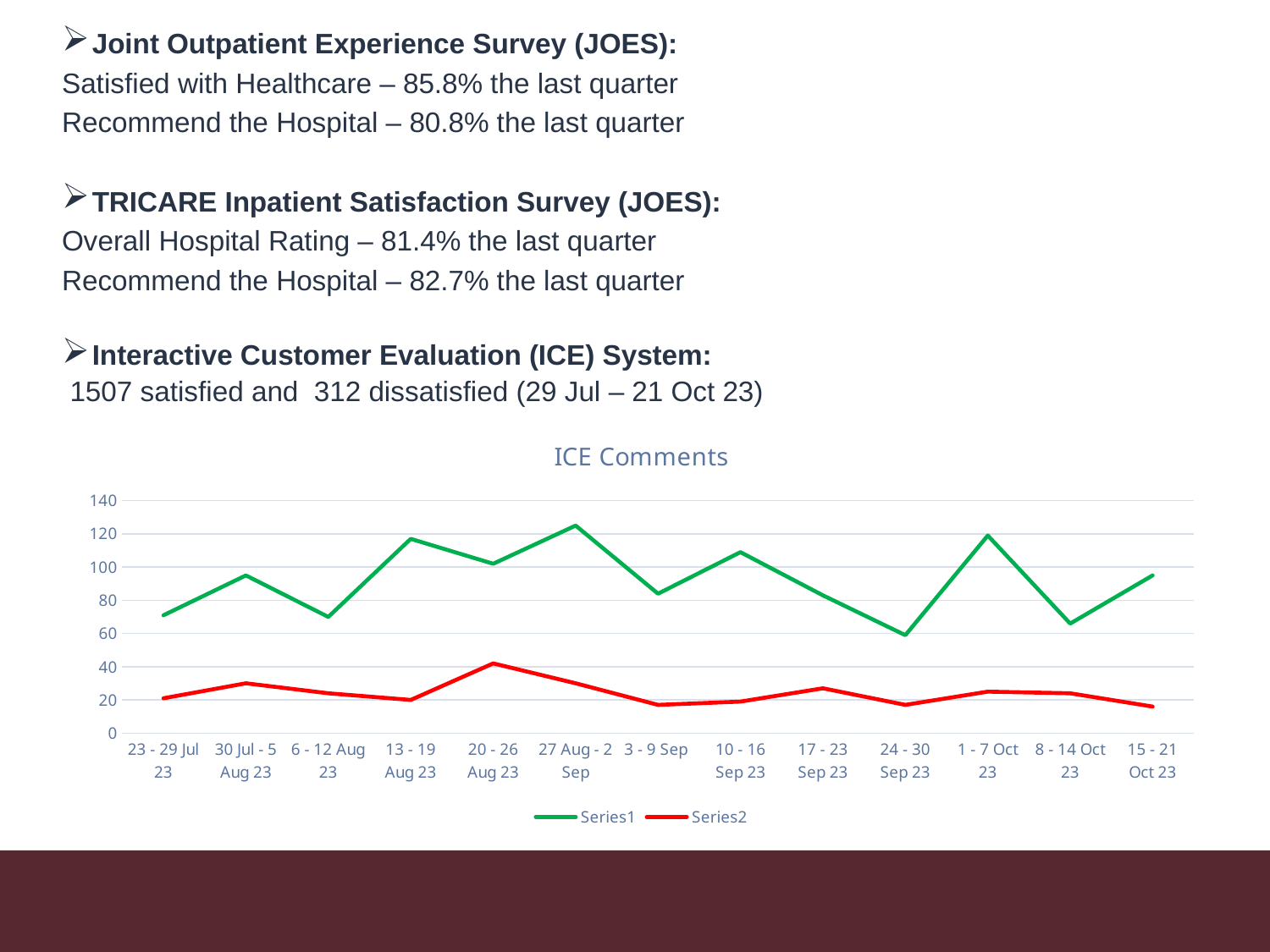
In the ICE Comments chart, which series has the larger value for 10 - 16 Sep 23, Series1 or Series2? Series1 What is the title of the chart on the slide? ICE Comments In the ICE Comments chart, is the Series1 value for 27 Aug - 2 Sep greater or less than 120? greater In the ICE Comments chart, in which period does Series2 reach its highest value? 20 - 26 Aug 23 In the ICE Comments chart, in which period does Series1 reach its highest value? 27 Aug - 2 Sep What colour is the Series1 line in the ICE Comments chart? green How many weekly periods are shown on the x axis of the ICE Comments chart? 13 In the ICE Comments chart, is the Series2 value for 15 - 21 Oct 23 greater or less than 20? less How many series does the legend of the ICE Comments chart list? 2 What kind of chart is the ICE Comments chart? line chart In the ICE Comments chart, does the Series1 line rise or fall from 1 - 7 Oct 23 to 8 - 14 Oct 23? fall In the ICE Comments chart, is the Series1 value for 24 - 30 Sep 23 greater or less than 80? less